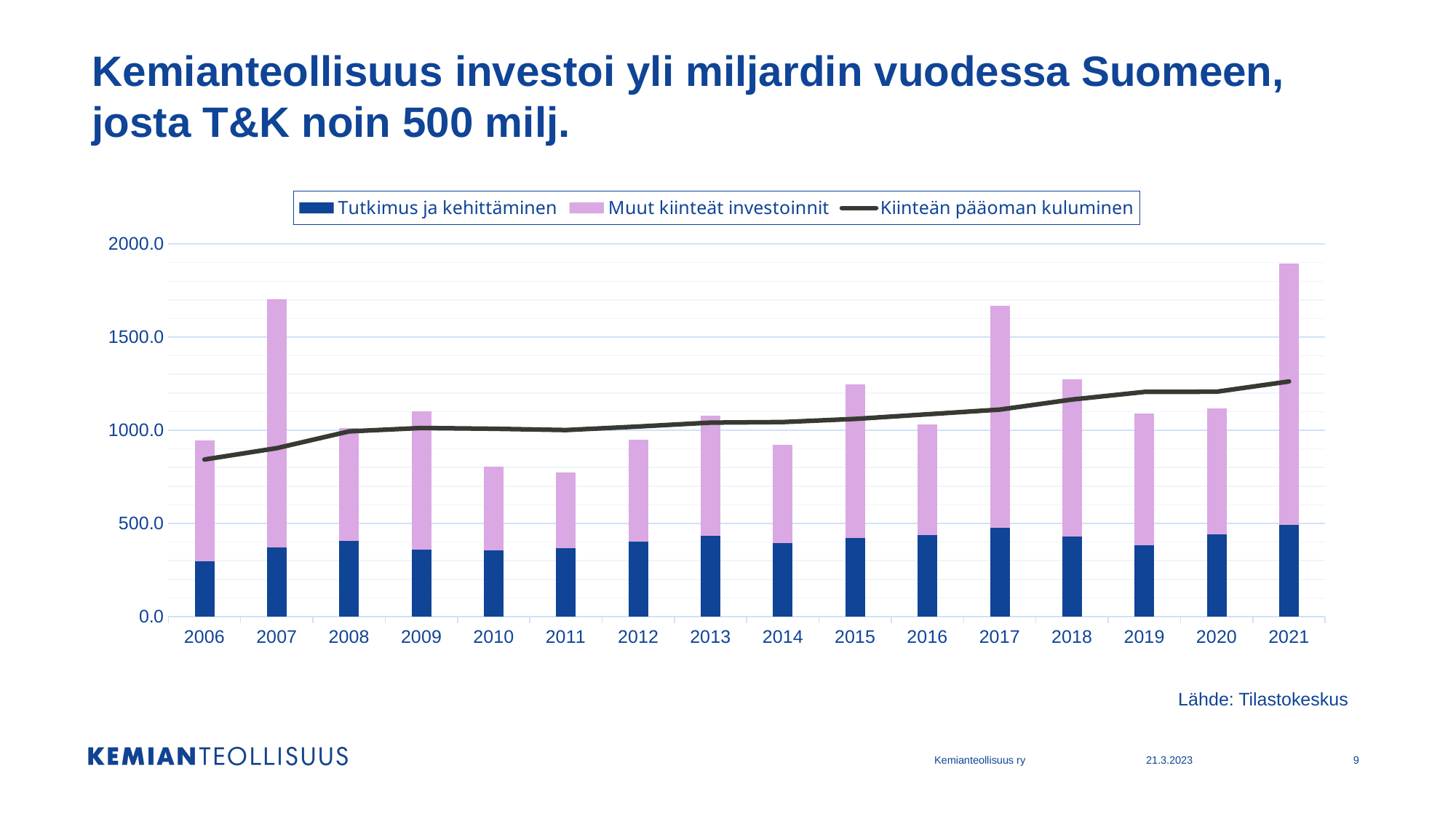
Is the total stacked bar value for 2010 greater or less than 1000? less Which year has the tallest stacked bar (highest total investment)? 2021 Which series is shown in pink in the chart? Muut kiinteät investoinnit Which year has a larger total stacked bar, 2007 or 2008? 2007 Is the value of the Kiinteän pääoman kuluminen line in 2006 greater or less than 1000? less What source is cited for the chart data? Tilastokeskus Which year has the shortest stacked bar (lowest total investment)? 2011 What kind of chart is shown on the slide? Stacked bar chart with a line Is the total stacked bar value for 2021 greater or less than 1500? greater Does the Kiinteän pääoman kuluminen line generally rise or fall from 2006 to 2021? rise How many years are shown on the x axis of the chart? 16 How many series does the chart legend list? 3